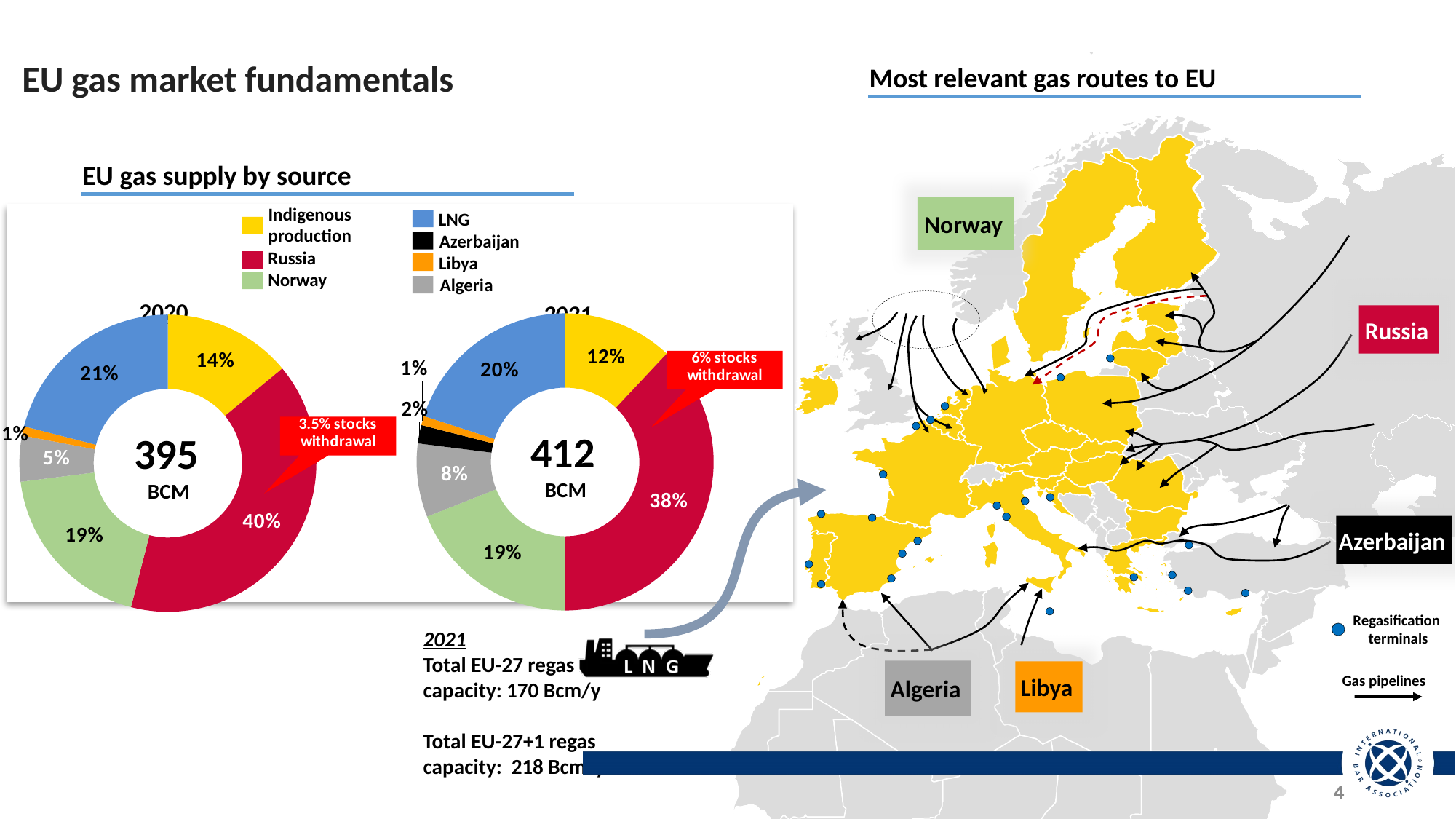
In the 2020 donut chart, what share of EU gas supply came from Russia? 40% In the 2021 donut chart, what share of EU gas supply came from Algeria? 8% How many sources does the legend of the EU gas supply by source charts list? 7 In the 2021 donut chart, what share of EU gas supply came from Russia? 38% In the 2020 donut chart, what share of EU gas supply came from Algeria? 5% What type of chart is used to show EU gas supply by source? Donut (pie) chart What total volume in BCM is shown in the centre of the 2020 donut chart? 395 By how many percentage points did Russia's share fall from the 2020 chart to the 2021 chart? 2 percentage points In the 2021 donut chart, which is larger: the share for Norway or the share for Indigenous production? Norway In the 2021 donut chart, what share of EU gas supply came from LNG? 20% What total volume in BCM is shown in the centre of the 2021 donut chart? 412 In the 2020 donut chart, which source has the largest share? Russia